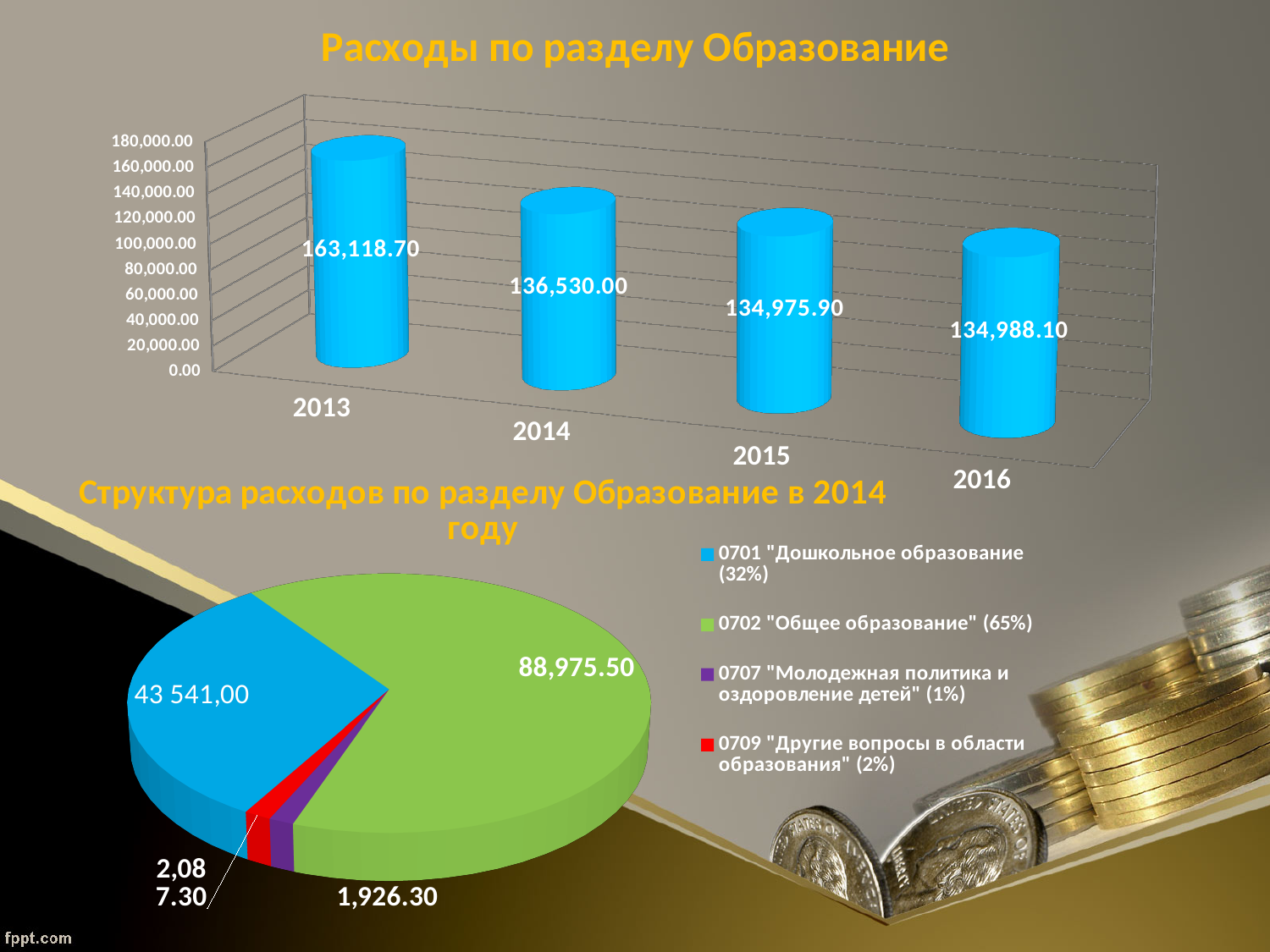
How many entries does the legend of the pie chart 'Структура расходов по разделу Образование в 2014 году' list? 4 In the bar chart 'Расходы по разделу Образование', which year has the lowest value? 2015 In the bar chart 'Расходы по разделу Образование', how many years are shown? 4 In the pie chart 'Структура расходов по разделу Образование в 2014 году', what is the value shown for the 0702 "Общее образование" slice? 88,975.50 In the bar chart 'Расходы по разделу Образование', which year has the highest value? 2013 In the bar chart 'Расходы по разделу Образование', what is the value for 2016? 134,988.10 In the pie chart 'Структура расходов по разделу Образование в 2014 году', what share does 0702 "Общее образование" have? 65% In the bar chart 'Расходы по разделу Образование', what is the value for 2014? 136,530.00 In the bar chart 'Расходы по разделу Образование', what is the difference between the values for 2013 and 2014? 26,588.70 In the bar chart 'Расходы по разделу Образование', what is the value for 2013? 163,118.70 What kind of chart is the top chart 'Расходы по разделу Образование'? bar chart In the bar chart 'Расходы по разделу Образование', is the value for 2013 greater or less than 160,000.00? greater